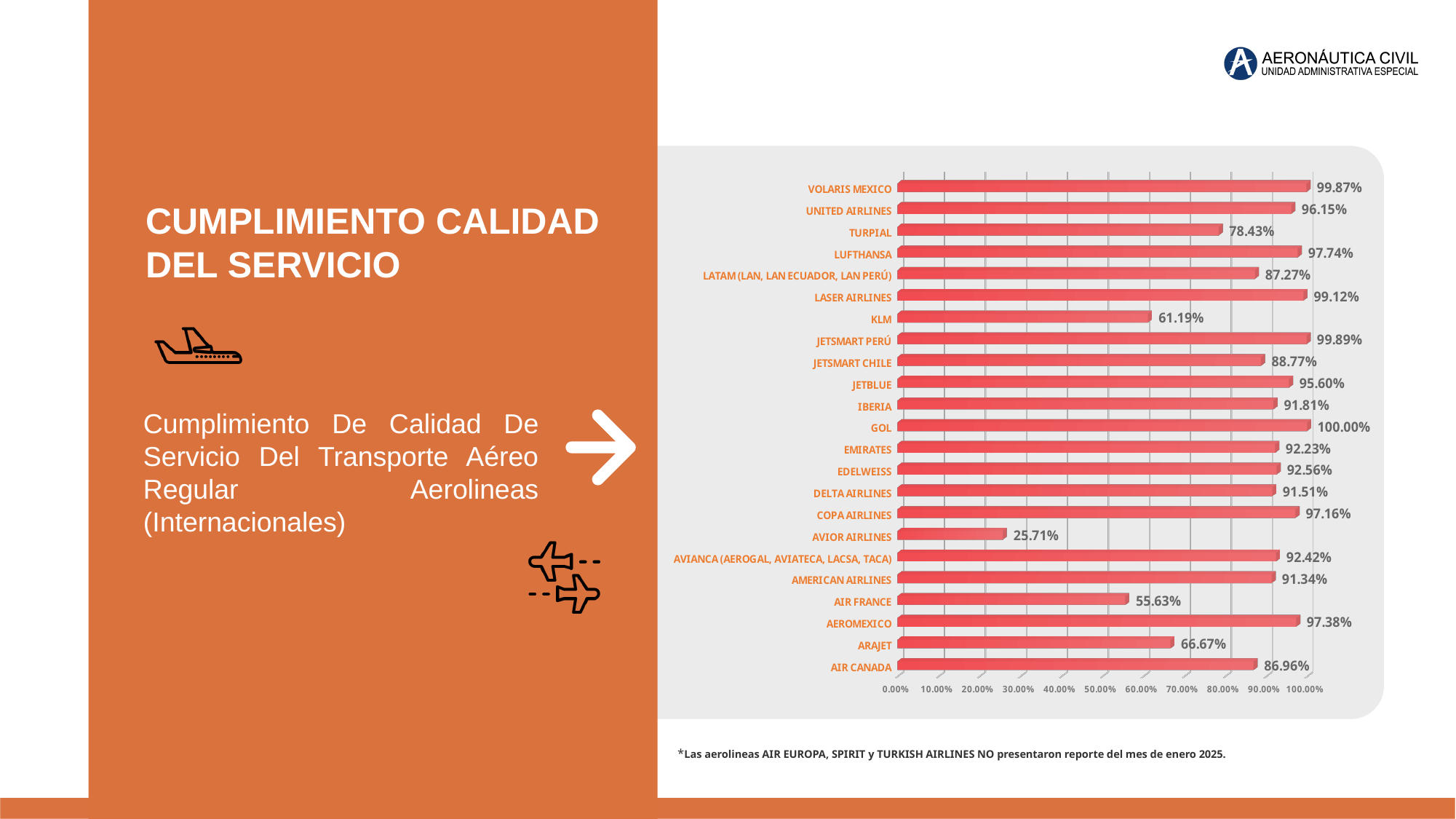
Which has a larger value, TURPIAL or ARAJET? TURPIAL What is the value for AIR CANADA? 86.96% What is the value for JETSMART CHILE? 88.77% Which airline has the lowest value? AVIOR AIRLINES What is the difference between the values for KLM and AIR FRANCE? 5.56% What is the difference between the values for GOL and AVIOR AIRLINES? 74.29% How many airlines are shown in the chart? 23 Which airline has the highest value? GOL What is the value for KLM? 61.19% Is the value for AIR FRANCE greater or less than 60.00%? less What kind of chart is shown on the slide? bar chart Which airlines does the footnote say did not submit a report for January 2025? AIR EUROPA, SPIRIT y TURKISH AIRLINES